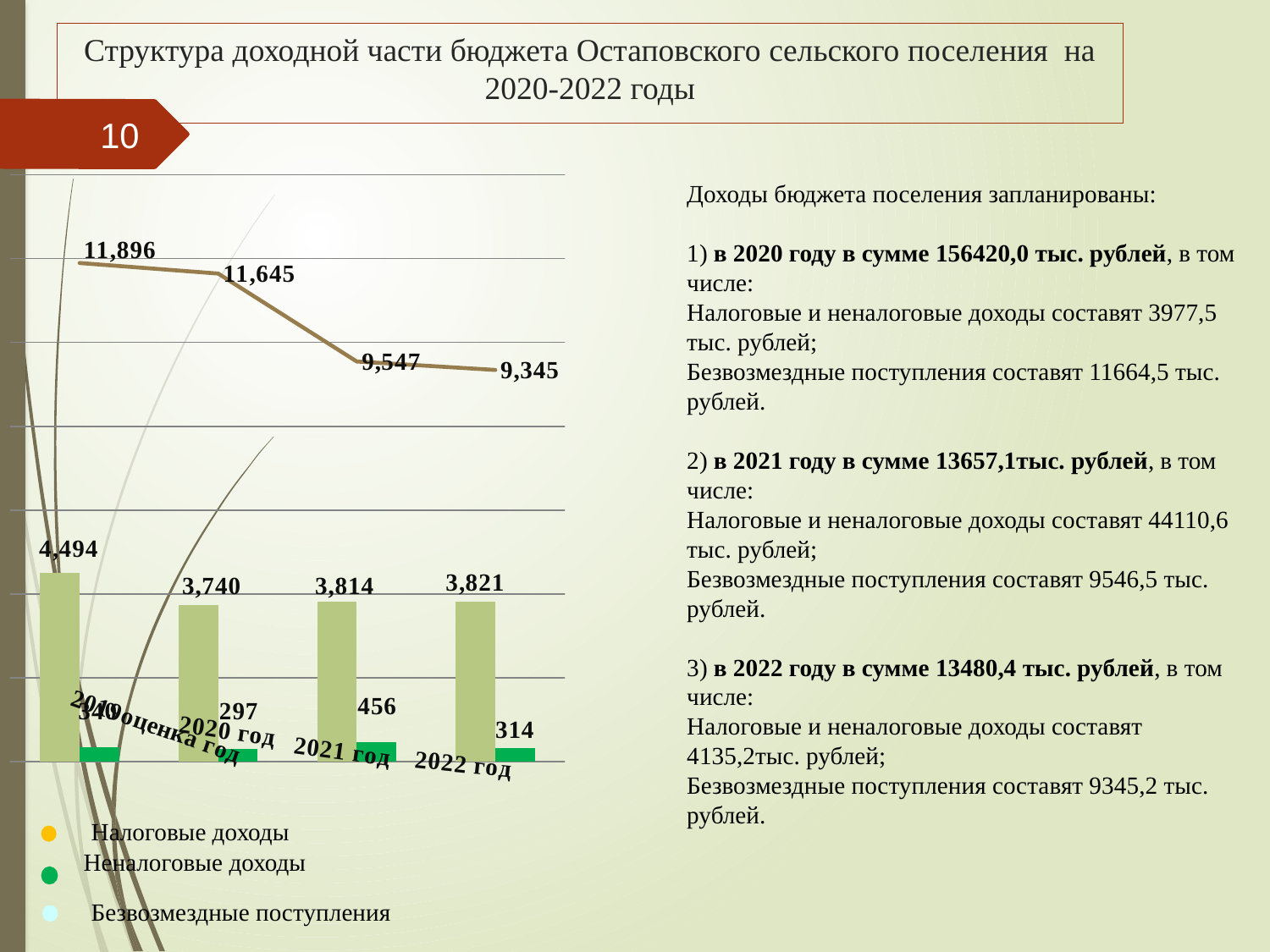
What is the value of the Неналоговые доходы bar for 2022 год? 314 What is the value of the Налоговые доходы bar for 2022 год? 3,821 Which year has the larger Неналоговые доходы value, 2021 год or 2022 год? 2021 год What is the highest value shown on the Безвозмездные поступления line? 11,896 Does the Безвозмездные поступления line rise or fall from left to right across the years? falls What is the value of the Безвозмездные поступления line for 2021 год? 9,547 What is the value of the Безвозмездные поступления line for 2022 год? 9,345 What is the value of the Неналоговые доходы bar for 2021 год? 456 What is the difference between the Безвозмездные поступления values for 2021 год and 2022 год? 202 How many series does the legend list? 3 What kind of chart is shown on the slide? combined bar and line chart What is the value of the Налоговые доходы bar for 2021 год? 3,814